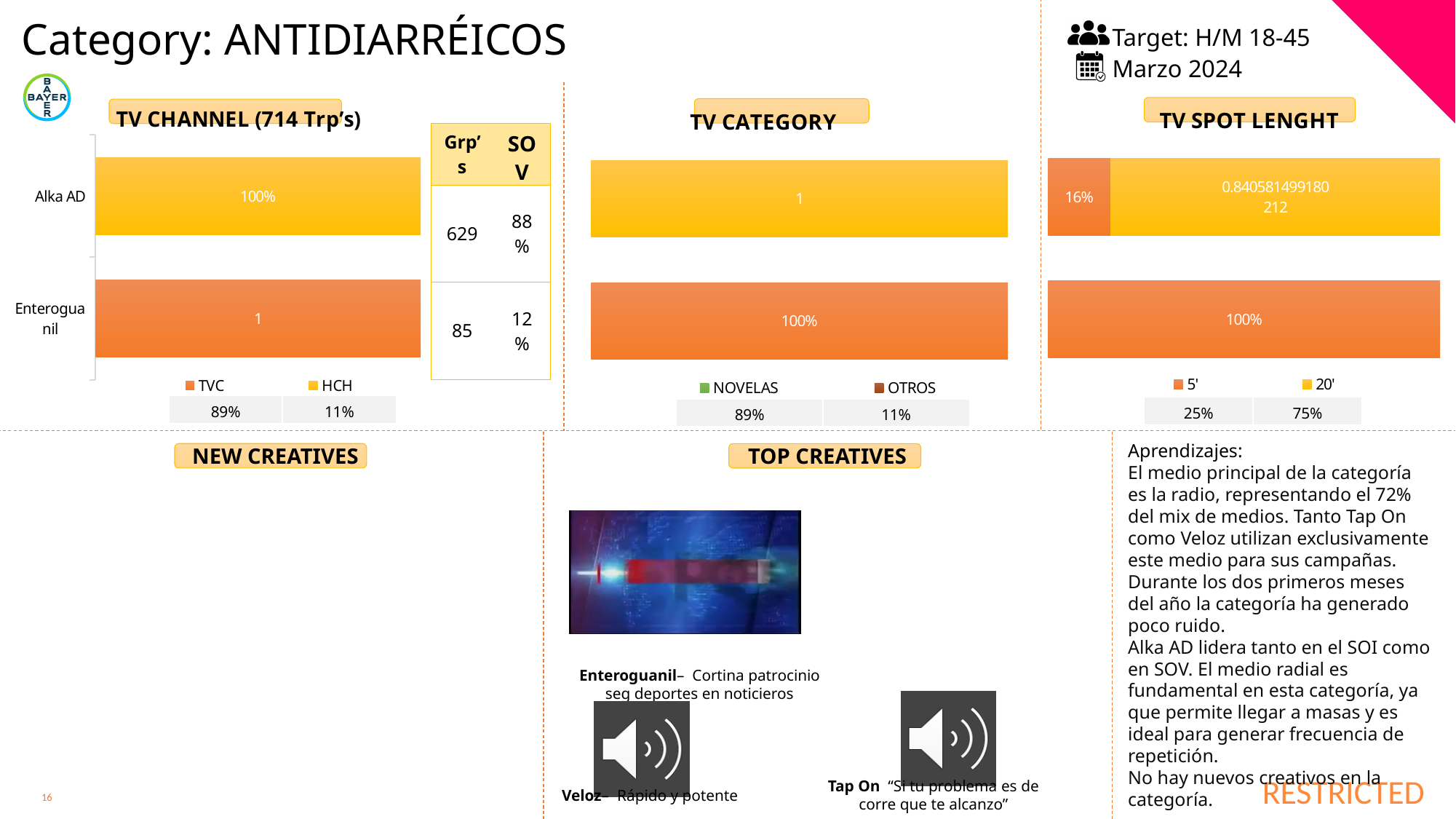
In the TV CHANNEL (714 Trp's) chart, what value is printed on the Enteroguanil bar? 1 In the TV SPOT LENGHT chart, what value is printed on the bottom bar? 100% What kind of chart is the TV CHANNEL (714 Trp's) chart? bar chart In the TV SPOT LENGHT chart, what percentage is printed on the orange (5') segment of the top bar? 16% How many series does the legend of the TV CATEGORY chart list? 2 Which two series are listed in the legend of the TV CHANNEL (714 Trp's) chart? TVC and HCH Which two series are listed in the legend of the TV SPOT LENGHT chart? 5' and 20' How many series does the legend of the TV CHANNEL (714 Trp's) chart list? 2 In the TV CATEGORY chart, what value is printed on the bottom (orange) bar? 100% How many categories (brands) are shown in the TV CHANNEL (714 Trp's) chart? 2 In the TV CHANNEL (714 Trp's) chart, what value is printed on the Alka AD bar? 100% What kind of chart is the TV SPOT LENGHT chart? bar chart